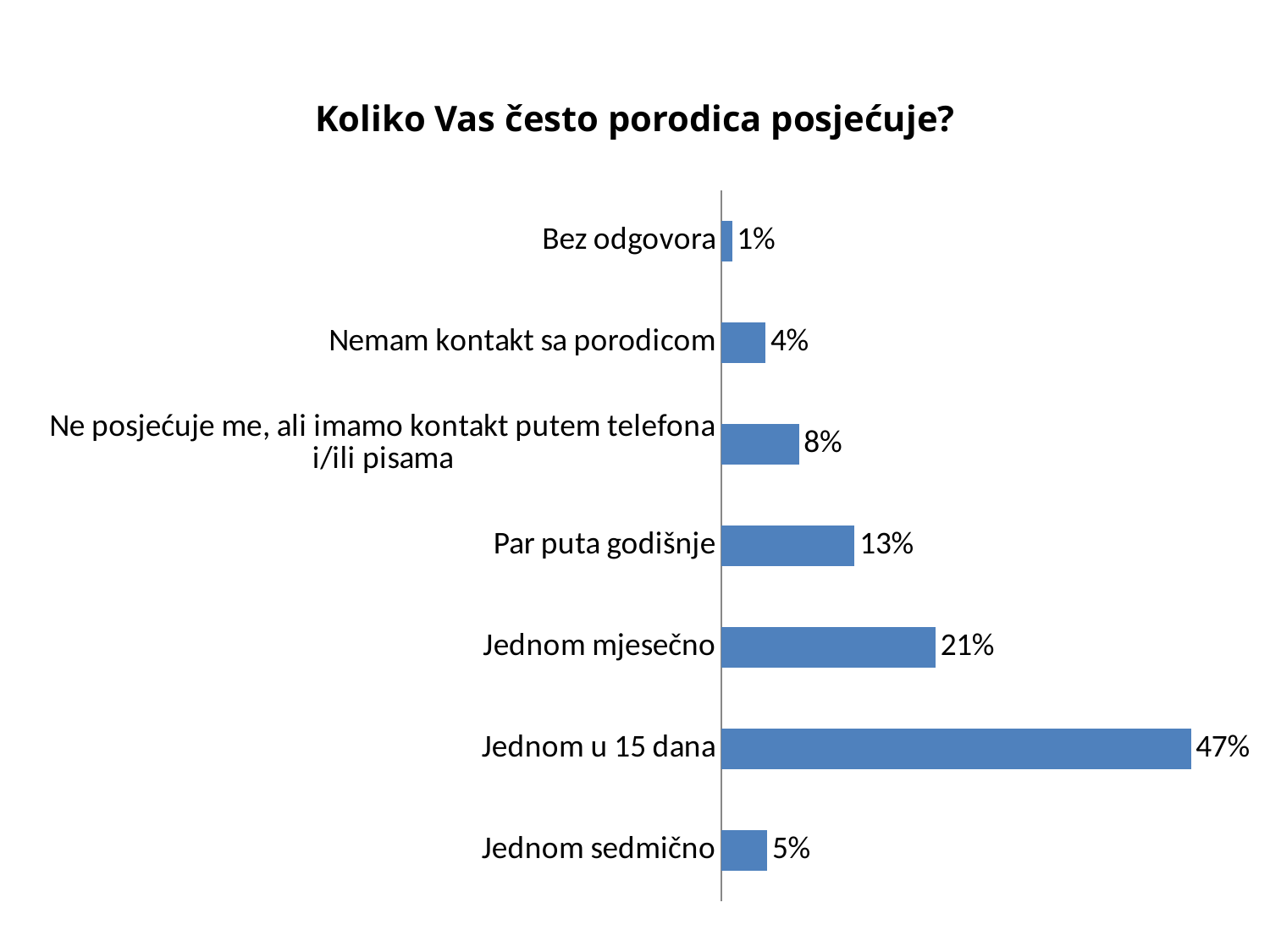
What is the value for "Par puta godišnje"? 13% What is the value for "Jednom u 15 dana"? 47% What kind of chart is shown on the slide? Bar chart Which is larger, the value for "Jednom sedmično" or the value for "Nemam kontakt sa porodicom"? Jednom sedmično Which category has the lowest value? Bez odgovora How many categories are shown in the chart? 7 Which category has the highest value? Jednom u 15 dana What is the value for "Jednom mjesečno"? 21% What is the title of the chart? Koliko Vas često porodica posjećuje? What is the value for "Nemam kontakt sa porodicom"? 4% What is the difference between the values for "Jednom u 15 dana" and "Jednom mjesečno"? 26% What is the value for "Jednom sedmično"? 5%